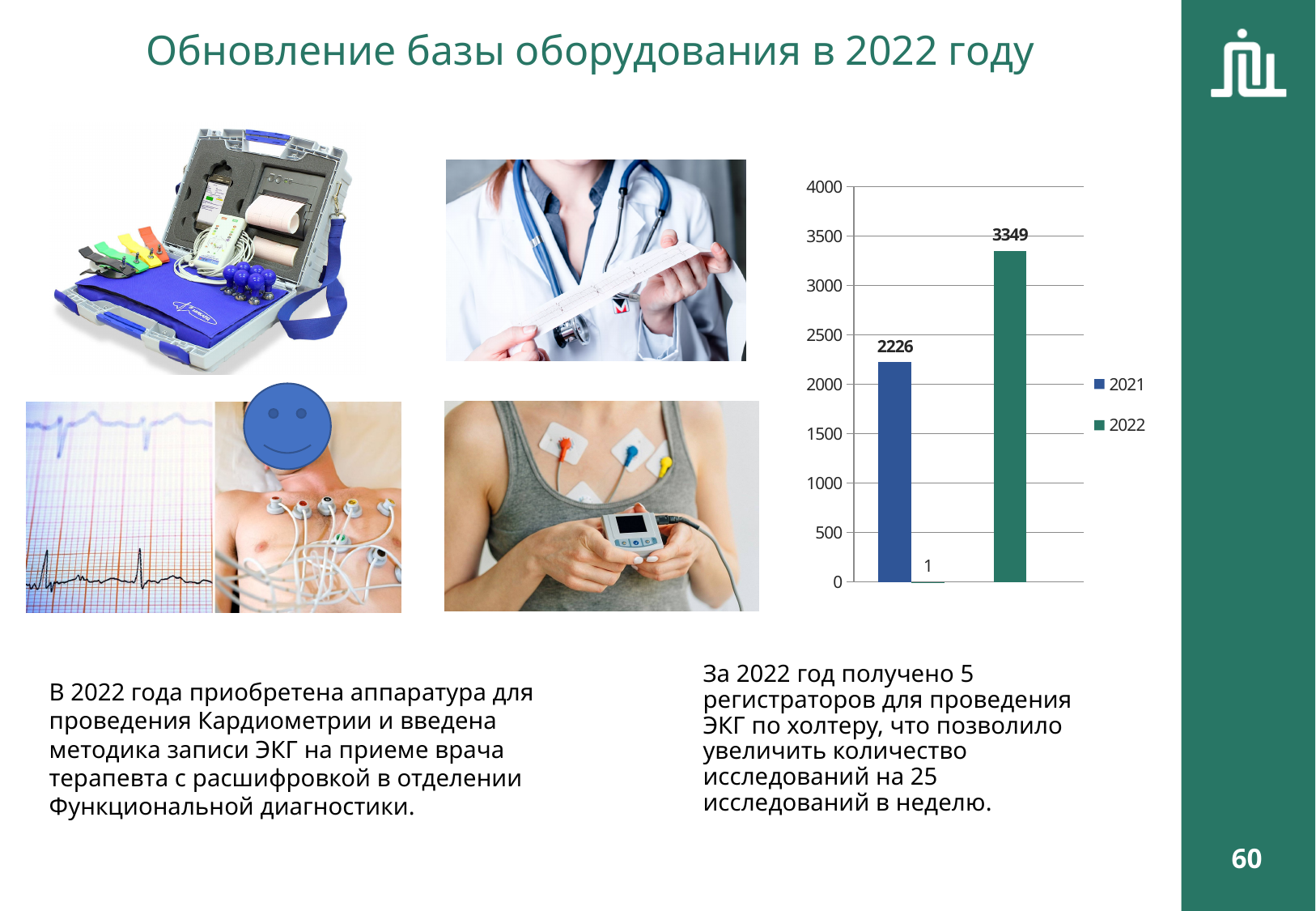
Which series has the highest value in the chart? 2022 By how much does the 2022 value exceed the 2021 value? 1123 What is the maximum value shown on the chart's vertical axis? 4000 Which year has the higher value in the chart, 2021 or 2022? 2022 Is the value for 2021 greater or less than 2500? less What value is shown for 2022 in the chart? 3349 Is the value for 2022 greater or less than 3000? greater What kind of chart is shown on the slide? Bar chart How many series does the chart legend list? 2 What value is shown for 2021 in the chart? 2226 What colour is the bar for 2022 in the chart? Green